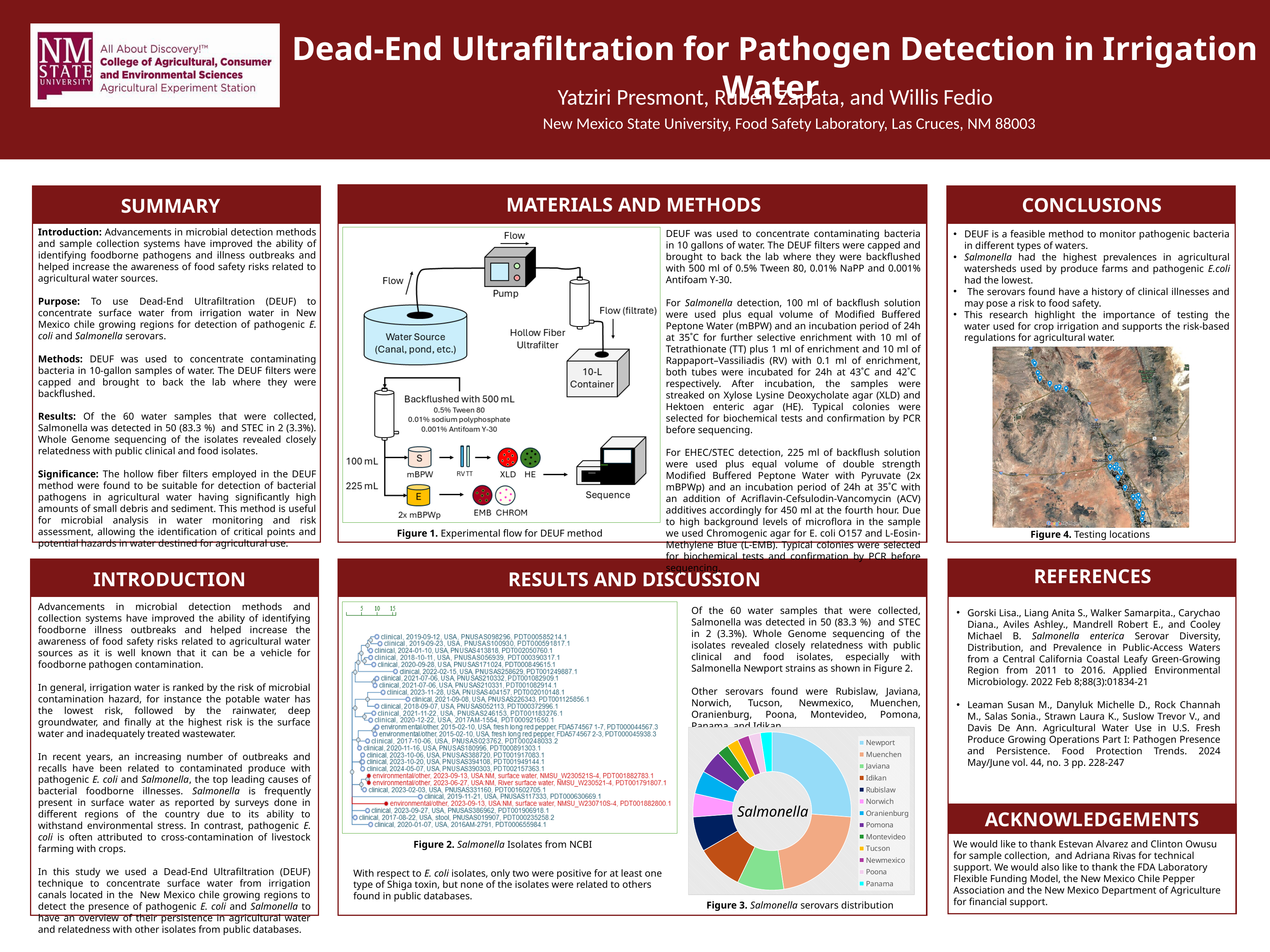
In Figure 3, which slice is larger, Newport or Rubislaw? Newport In Figure 3, which slice is larger, Muenchen or Javiana? Muenchen What is the caption of the doughnut chart on the slide? Figure 3. Salmonella serovars distribution What word is printed in the centre of the doughnut chart in Figure 3? Salmonella In Figure 3, which Salmonella serovar has the largest share of the doughnut? Newport In Figure 3, which serovar has the second-largest share of the doughnut? Muenchen What kind of chart is Figure 3, the Salmonella serovars distribution? Doughnut (pie) chart How many serovars does the legend of Figure 3 list? 13